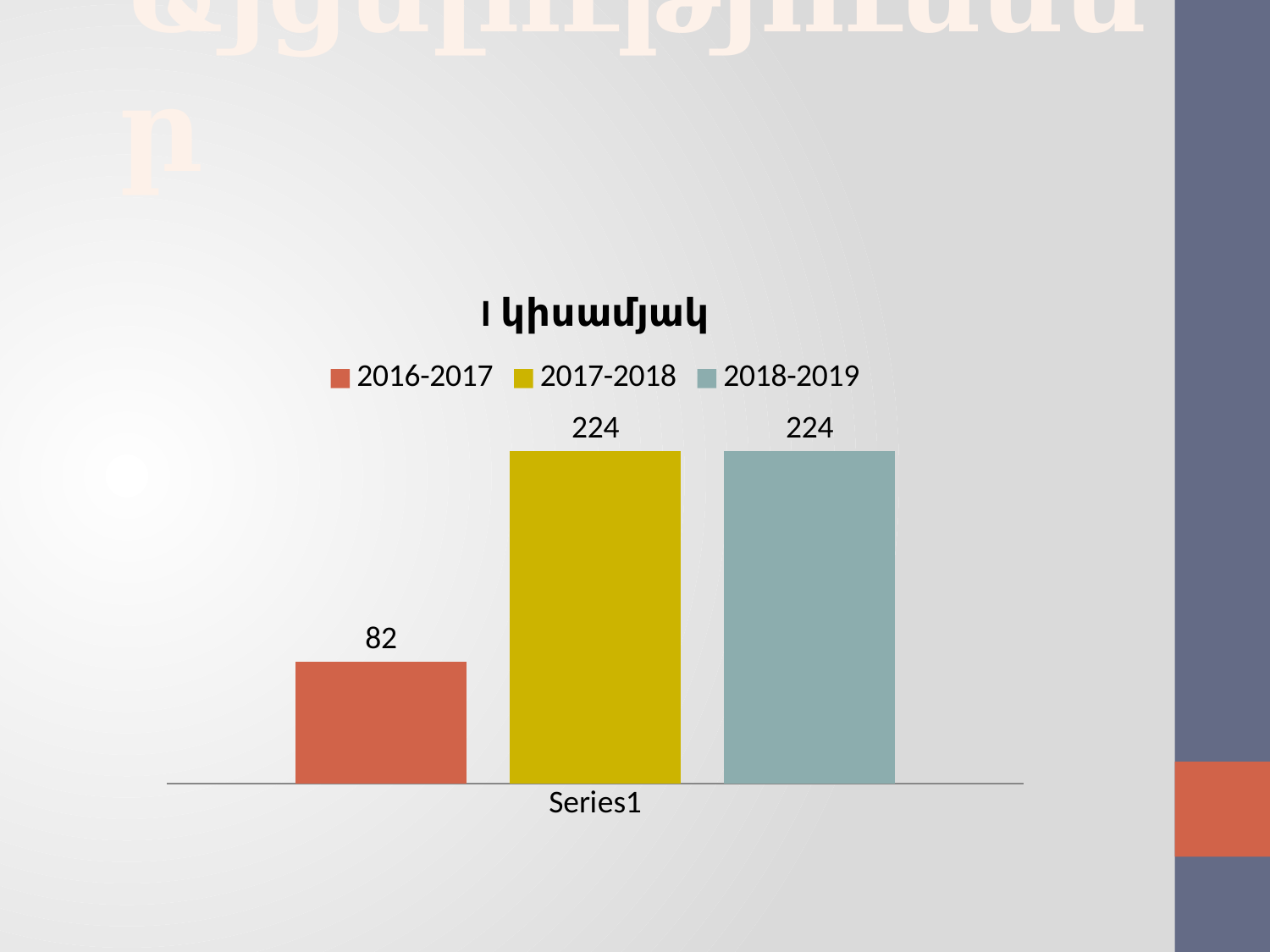
How many bars are plotted in the chart? 3 What is the title of the chart? I կիսամյակ Which series has the lowest value? 2016-2017 What kind of chart is shown on the slide? bar chart What is the category label shown on the x axis? Series1 What is the value for 2018-2019? 224 How many series does the legend list? 3 What colour is the bar for 2017-2018? yellow What is the value for 2017-2018? 224 Which is larger, the value for 2016-2017 or the value for 2018-2019? 2018-2019 What is the difference between the values for 2017-2018 and 2016-2017? 142 What is the value for 2016-2017? 82